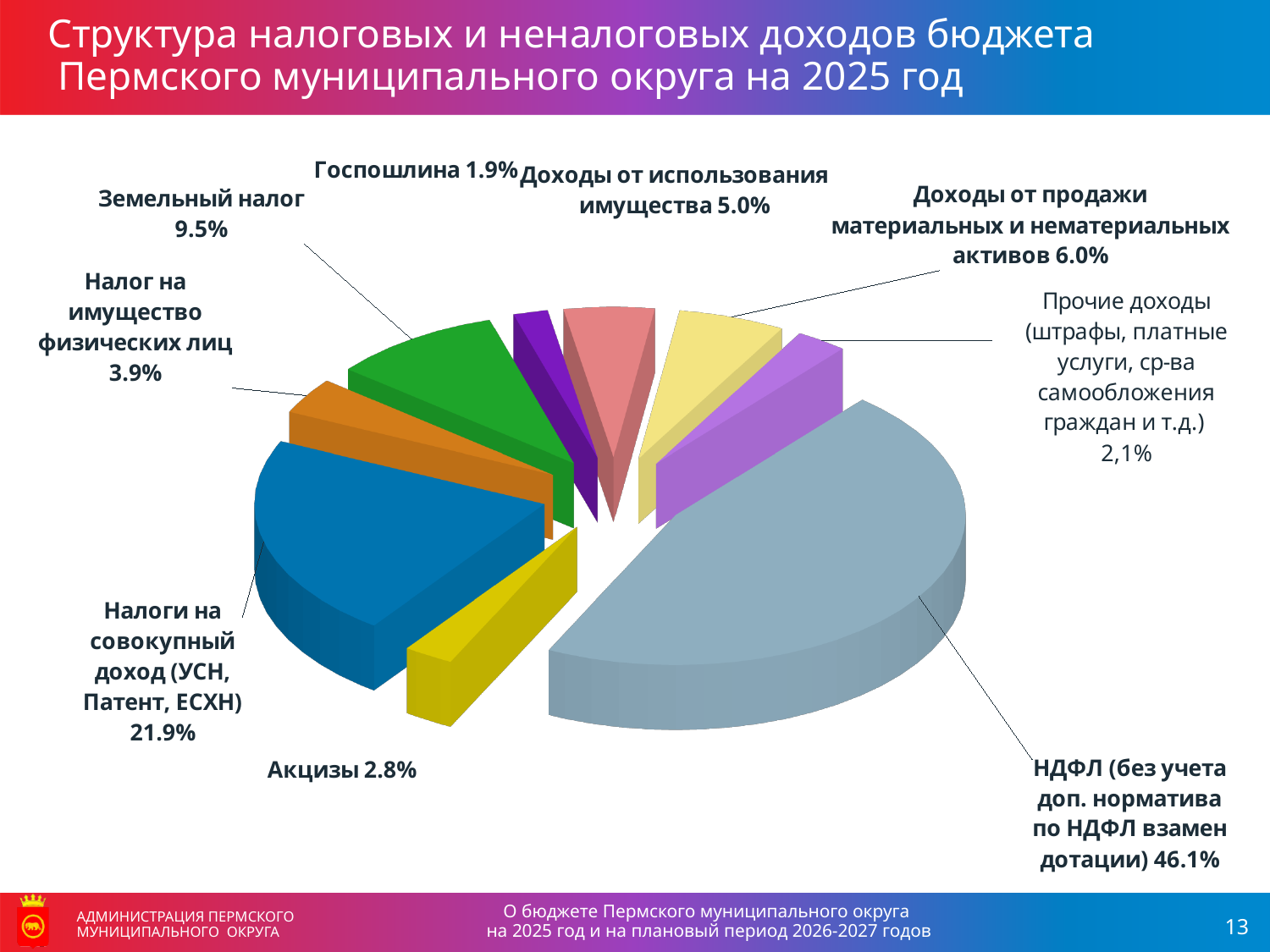
Which category has the smallest share of the pie? Госпошлина How many slices does the pie chart have? 9 What is the difference in percentage points between НДФЛ (46.1%) and Налоги на совокупный доход (21.9%)? 24.2 What share is shown for Прочие доходы (штрафы, платные услуги, ср-ва самообложения граждан и т.д.)? 2,1% Which category has the largest share of the pie? НДФЛ (без учета доп. норматива по НДФЛ взамен дотации) What share of the budget revenue is НДФЛ (без учета доп. норматива по НДФЛ взамен дотации)? 46.1% What share is shown for Налоги на совокупный доход (УСН, Патент, ЕСХН)? 21.9% What share is shown for Акцизы? 2.8% What share is shown for Доходы от продажи материальных и нематериальных активов? 6.0% What kind of chart is shown on the slide? pie chart Which is larger: the share for Доходы от использования имущества or the share for Налог на имущество физических лиц? Доходы от использования имущества What share is shown for Земельный налог? 9.5%